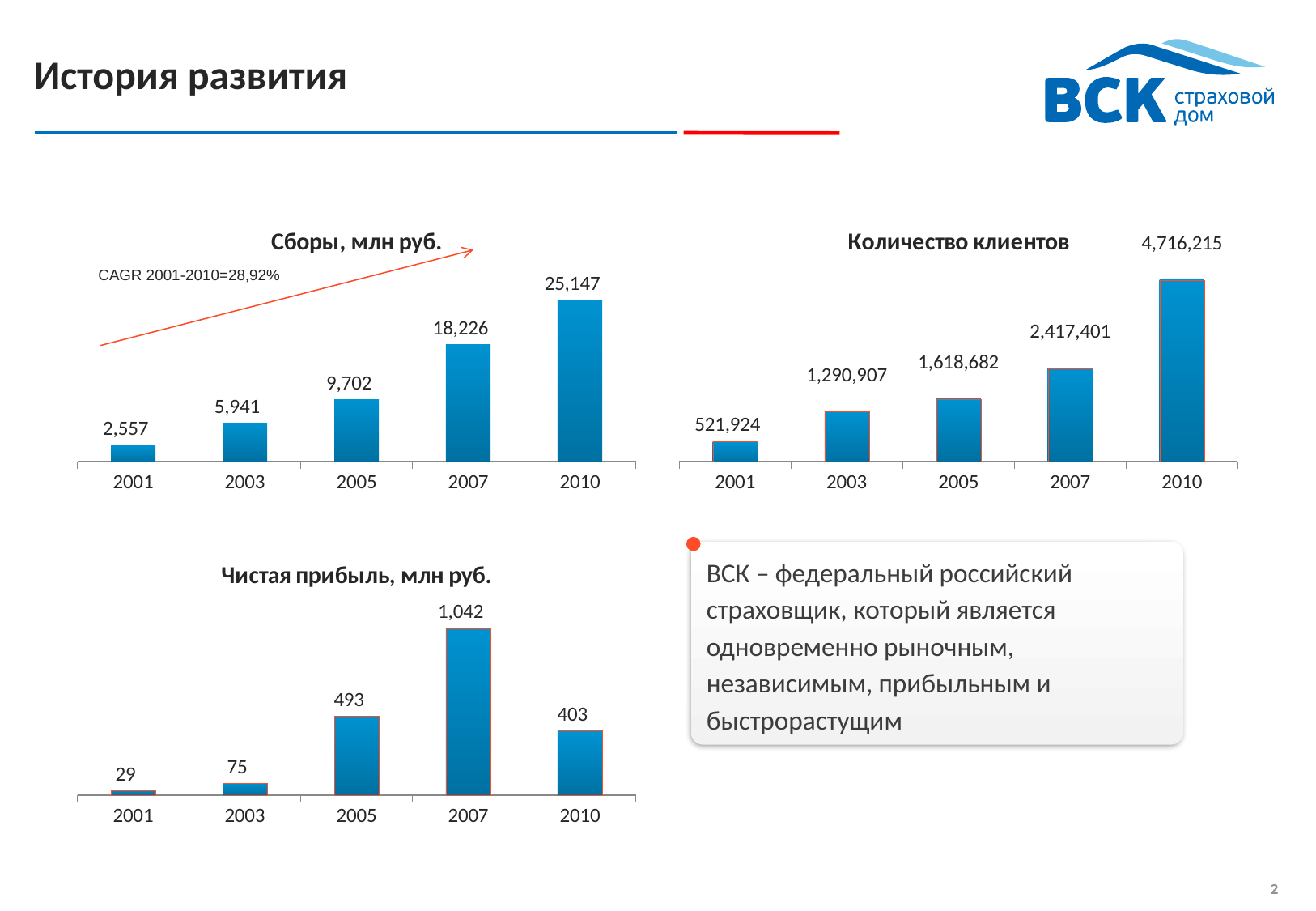
In the chart titled "Чистая прибыль, млн руб.", which is larger, the value for 2005 or the value for 2010? 2005 In the chart titled "Сборы, млн руб.", what is the difference between the values for 2010 and 2007? 6,921 In the chart titled "Сборы, млн руб.", do the values rise or fall from 2001 to 2010? rise In the chart titled "Количество клиентов", which year has the lowest value? 2001 In the chart titled "Количество клиентов", how many years are shown on the x axis? 5 What type of chart is the chart titled "Сборы, млн руб."? bar chart In the chart titled "Чистая прибыль, млн руб.", what is the difference between the values for 2003 and 2001? 46 In the chart titled "Чистая прибыль, млн руб.", what is the value for 2010? 403 In the chart titled "Количество клиентов", what is the value for 2007? 2,417,401 In the chart titled "Сборы, млн руб.", what is the value for 2005? 9,702 In the chart titled "Чистая прибыль, млн руб.", which year has the highest value? 2007 In the chart titled "Сборы, млн руб.", what is the value for 2010? 25,147